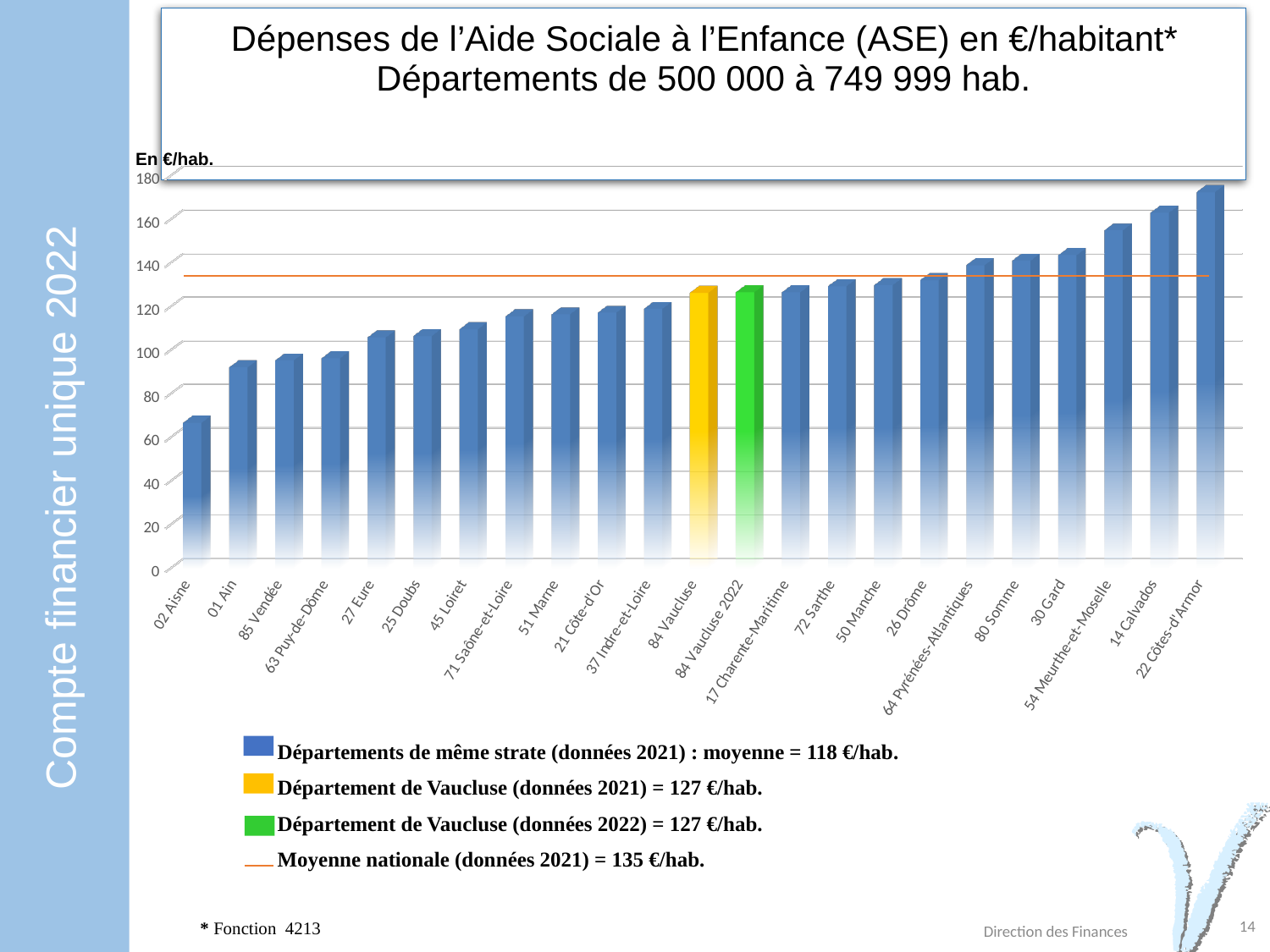
What colour is the bar for 84 Vaucluse 2022? green Which department has the lowest ASE spending per inhabitant on the chart? 02 Aisne Is the value for 22 Côtes-d'Armor greater or less than 160? greater How many departments (bars) are plotted on the chart? 23 Is the value for 02 Aisne greater or less than 80? less Which has the larger value, 30 Gard or 01 Ain? 30 Gard According to the legend, what is the ASE spending per inhabitant for Département de Vaucluse (données 2021)? 127 €/hab. According to the legend, what is the average for Départements de même strate (données 2021)? 118 €/hab. Which department has the highest ASE spending per inhabitant on the chart? 22 Côtes-d'Armor What kind of chart is shown on the slide? bar chart Do the bar values rise or fall from left to right along the x axis? rise According to the legend, what is the Moyenne nationale (données 2021) shown by the orange line? 135 €/hab.